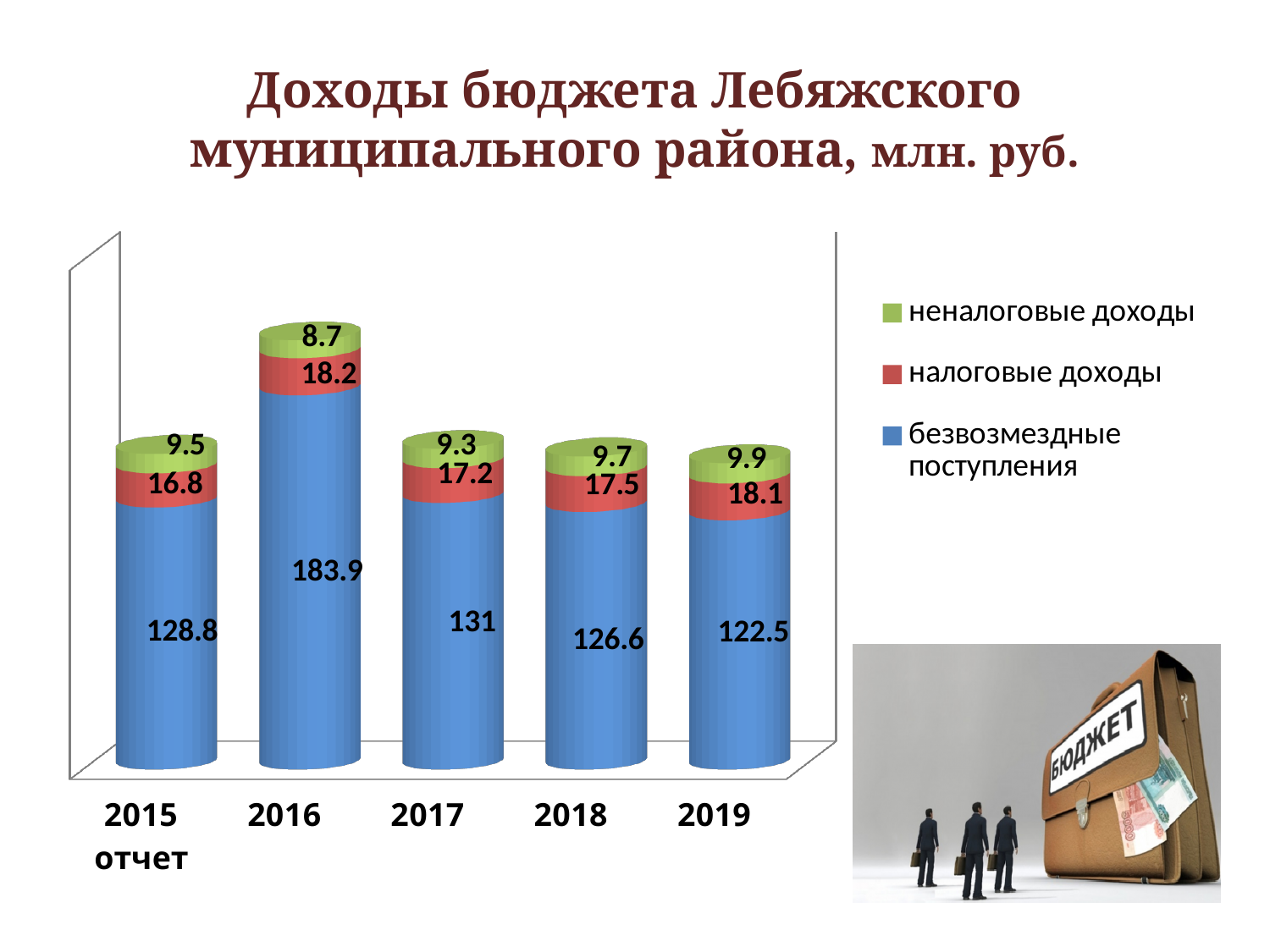
What is the value of налоговые доходы for 2019? 18.1 Which year has the highest value of безвозмездные поступления? 2016 How many years are shown on the x axis? 5 What is the total of the stacked bar for 2015? 155.1 Which year has the lowest value of неналоговые доходы? 2016 How many series does the legend list? 3 Which is larger: налоговые доходы in 2018 or in 2017? 2018 Which colour represents налоговые доходы in the legend? red What is the value of безвозмездные поступления for 2016? 183.9 What is the value of неналоговые доходы for 2015? 9.5 What kind of chart is shown on the slide? stacked bar chart What is the difference between безвозмездные поступления in 2016 and 2017? 52.9